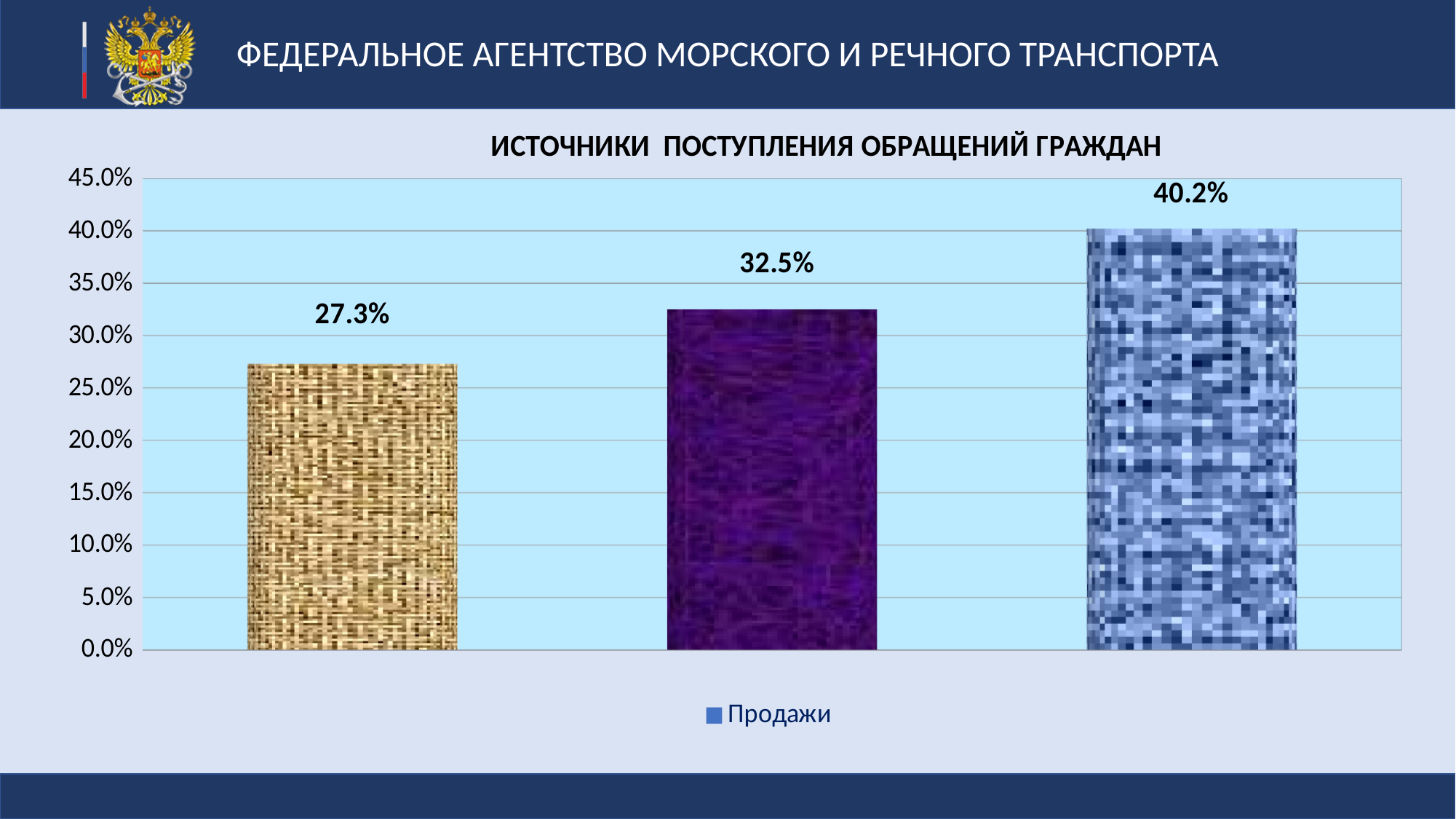
What is the difference between the middle bar's value and the left bar's value? 5.2% How many series does the legend list? 1 What is the value shown on the left (beige) bar? 27.3% What is the difference between the right bar's value and the left bar's value? 12.9% What is the value shown on the right (blue) bar? 40.2% Is the value of the right bar greater or less than 35.0%? greater What is the value shown on the middle (purple) bar? 32.5% How many bars are plotted in the chart? 3 Which is larger, the value of the middle bar or the value of the left bar? the middle bar What kind of chart is shown on the slide? bar chart Which bar has the lowest value: the left, middle or right one? left Which bar has the highest value: the left, middle or right one? right